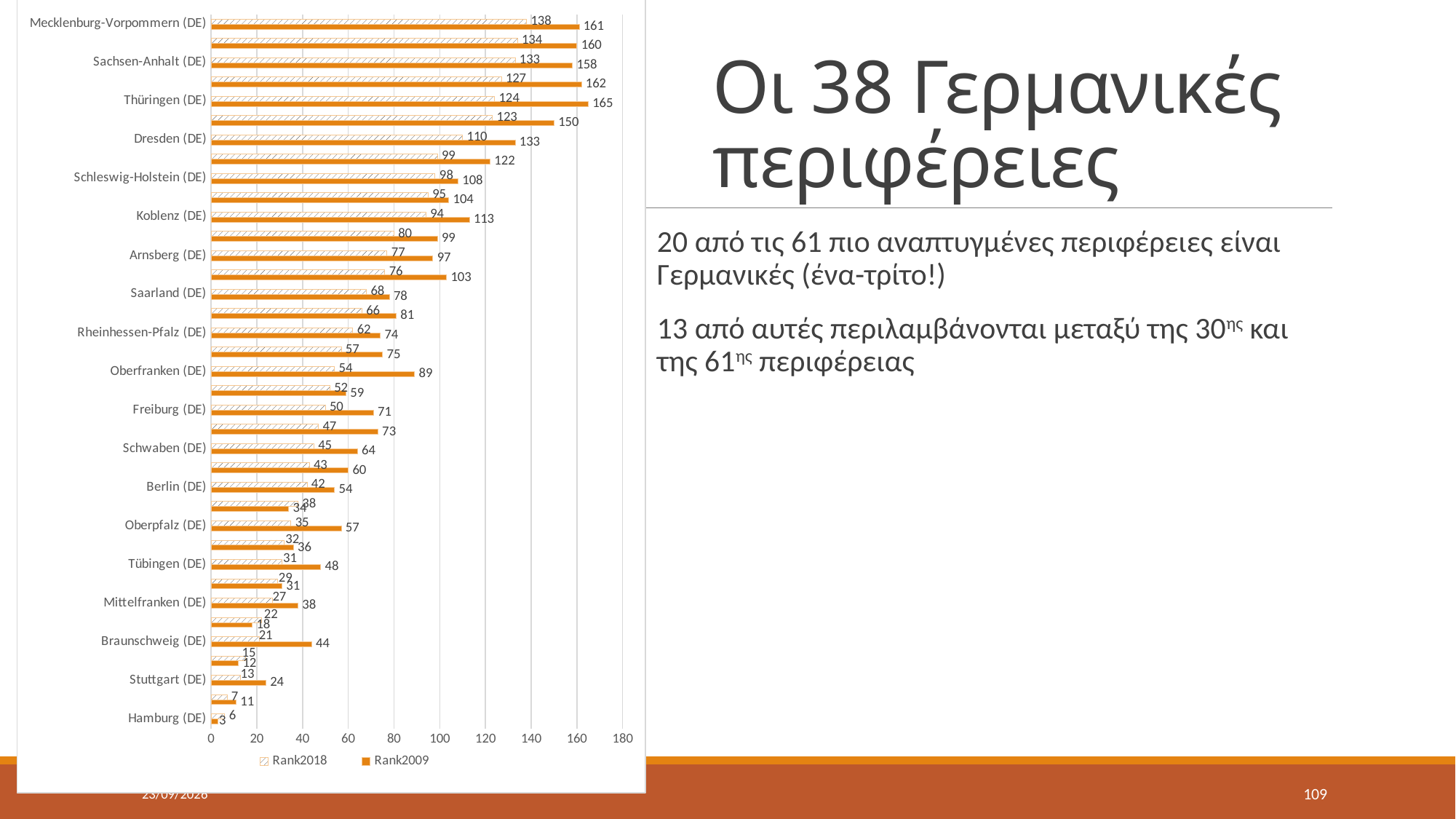
Which is larger for Berlin (DE): the Rank2018 value or the Rank2009 value? Rank2009 Which labelled region has the lowest Rank2018 value? Hamburg (DE) What is the difference between the Rank2009 and Rank2018 values for Braunschweig (DE)? 23 What is the difference between the Rank2009 and Rank2018 values for Dresden (DE)? 23 What is the Rank2018 value for Hamburg (DE)? 6 What is the Rank2018 value for Mecklenburg-Vorpommern (DE)? 138 What is the Rank2009 value for Thüringen (DE)? 165 What kind of chart is shown on the slide? bar chart Which series is drawn with a hatched pattern in the chart? Rank2018 What is the Rank2009 value for Oberfranken (DE)? 89 Which labelled region has the highest Rank2009 value? Thüringen (DE) How many series does the chart legend list? 2